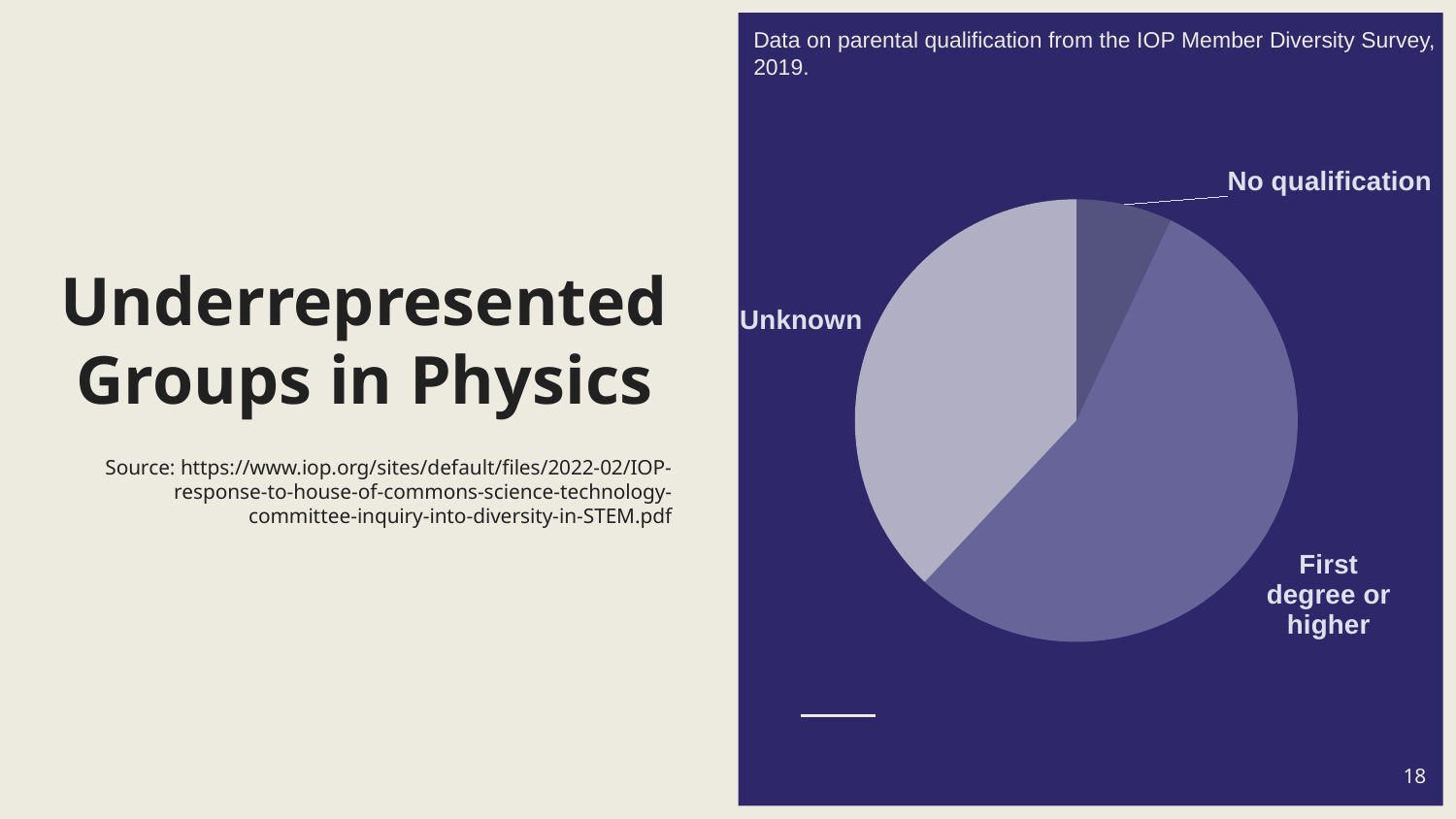
Which slice is larger: Unknown or No qualification? Unknown Which category has the largest slice of the pie chart? First degree or higher Which slice is larger: First degree or higher, or Unknown? First degree or higher What kind of chart is shown on the slide? Pie chart What does the caption above the pie chart say the data is about? Parental qualification from the IOP Member Diversity Survey, 2019 Which category label is connected to its slice by a leader line? No qualification Does the First degree or higher slice take up more or less than half of the pie? More Which category has the smallest slice of the pie chart? No qualification How many labelled categories does the pie chart show? 3